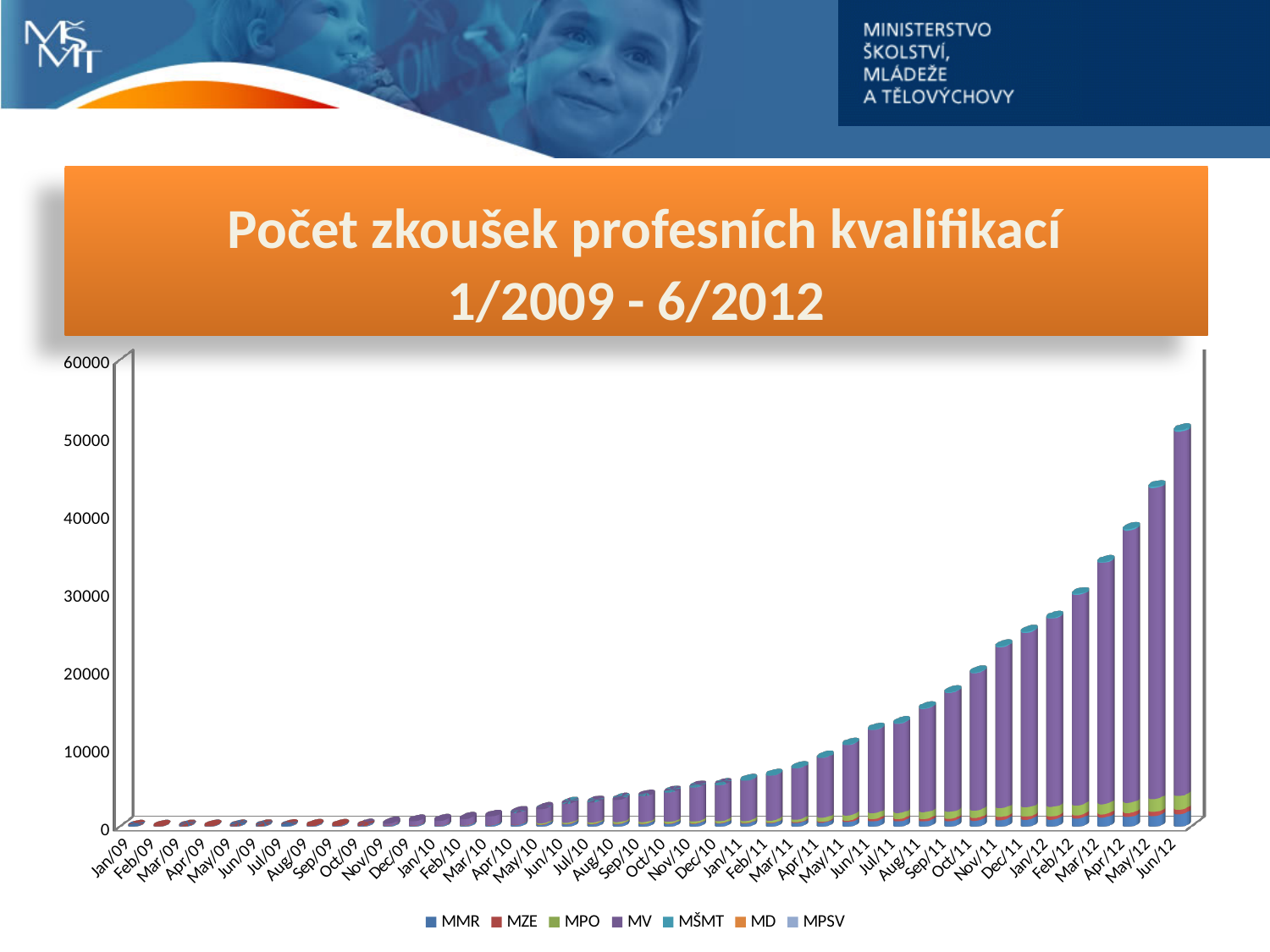
What is the title of the chart on the slide? Počet zkoušek profesních kvalifikací 1/2009 - 6/2012 How many months (categories) are plotted along the x axis? 42 Which series makes up the largest (purple) part of each stacked bar? MV How many series does the legend list? 7 What kind of chart is shown on the slide? bar chart Do the bar totals rise or fall from Jan/09 to Jun/12? rise Is the total for Jun/12 greater or less than 40000? greater Is the total for Jun/11 greater or less than 10000? greater Is the total for Dec/11 greater or less than 30000? less Which has the larger total bar, Jan/12 or Jun/12? Jun/12 Which month has the highest total bar? Jun/12